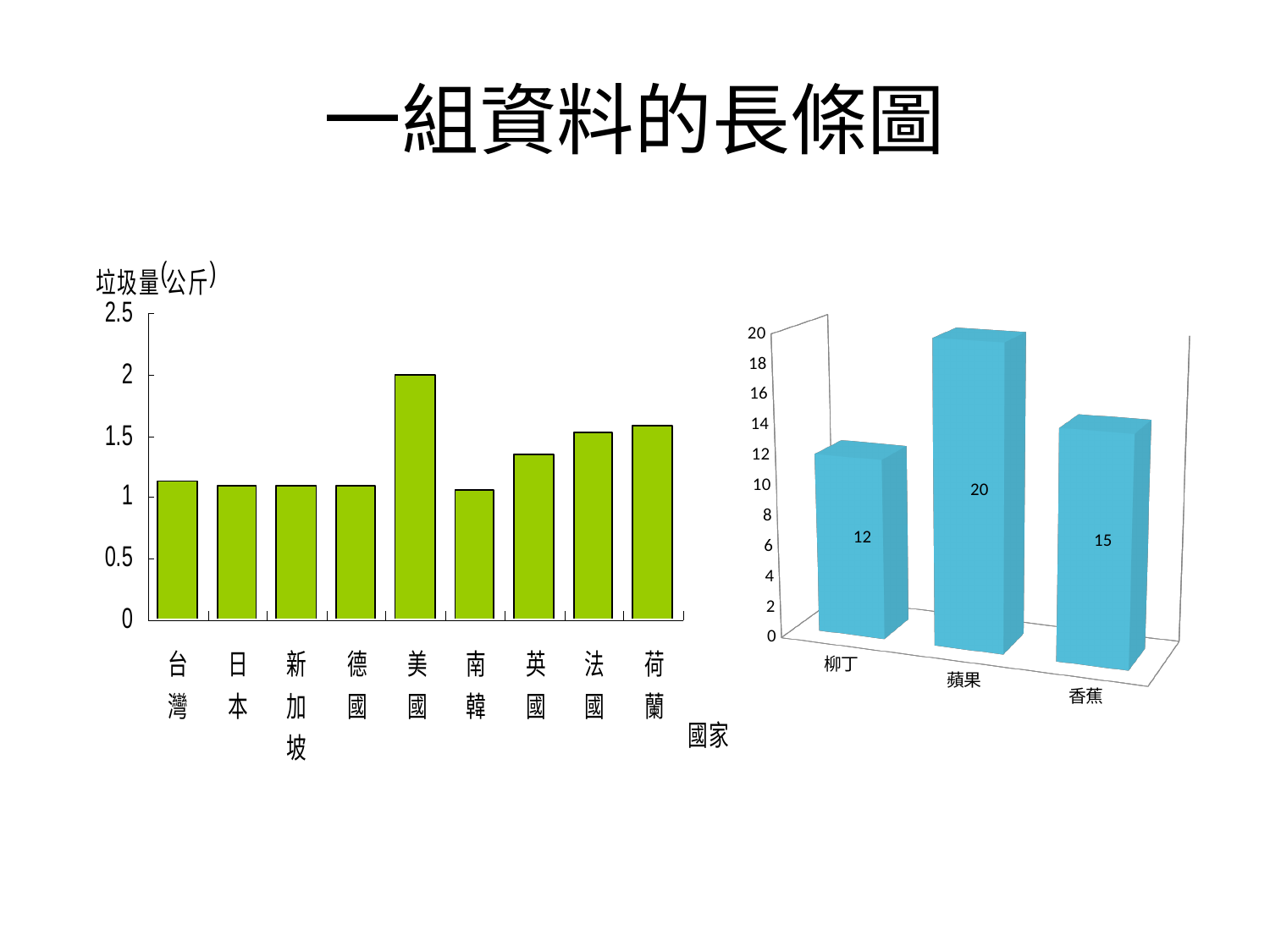
In the chart on the left, which country has the highest 垃圾量? 美國 In the chart on the right, what is the difference between the values for 蘋果 and 柳丁? 8 In the chart on the right, which is larger, the value for 香蕉 or the value for 柳丁? 香蕉 In the chart on the right, how many categories are shown? 3 In the chart on the left, how many countries are shown on the x axis? 9 In the chart on the left, is the value for 台灣 greater or less than 1.5? less In the chart on the right, which category has the highest value? 蘋果 In the chart on the right, what is the value for 柳丁? 12 In the chart on the right, what is the value for 蘋果? 20 In the chart on the left, is the value for 美國 greater or less than 1.5? greater In the chart on the right, which category has the lowest value? 柳丁 In the chart on the right, what is the value for 香蕉? 15